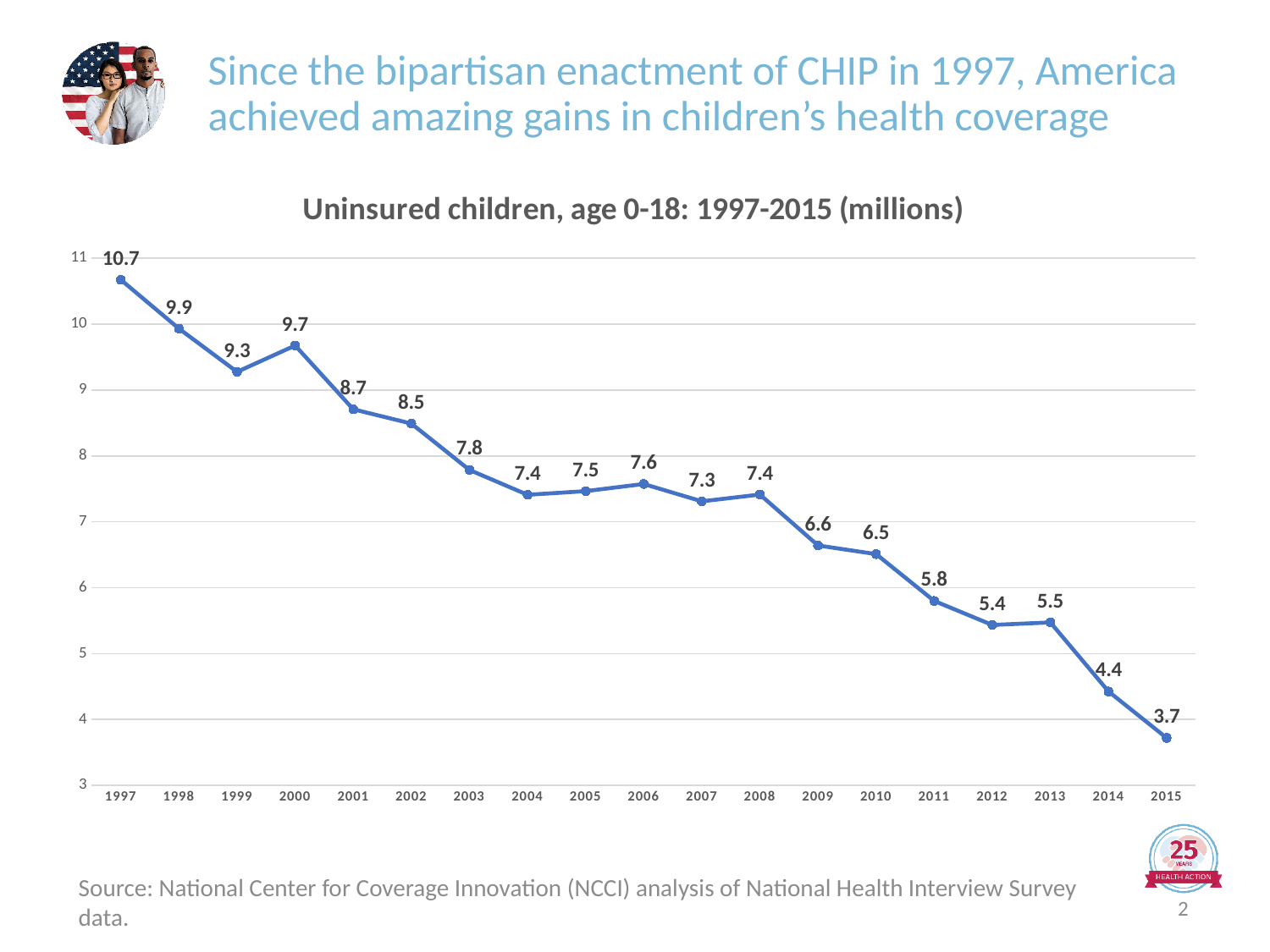
What is the value for 2008? 7.4 Which year has the lowest value? 2015 Which is larger, the value for 2000 or the value for 1999? 2000 What is the difference between the values for 2013 and 2014? 1.1 What is the difference between the values for 1997 and 2015? 7 What is the value for 1997? 10.7 Is the value for 2011 greater or less than 6? less What kind of chart is this? line chart Which year has the highest value? 1997 How many years are plotted on the chart? 19 Do the values generally rise or fall from 1997 to 2015? fall What is the value for 2015? 3.7